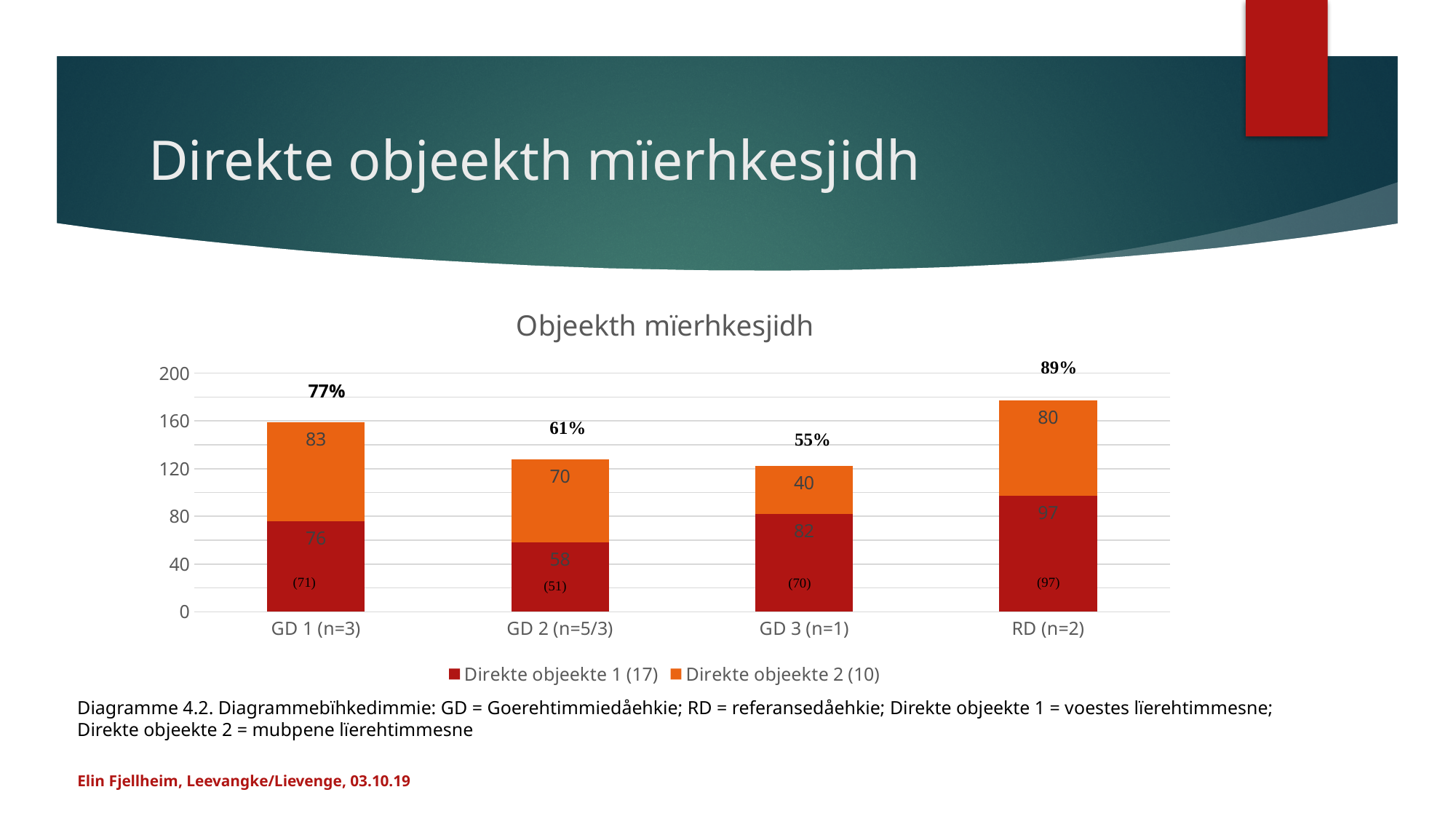
Which is larger: Direkte objeekte 1 (17) for GD 3 (n=1) or Direkte objeekte 1 (17) for GD 1 (n=3)? GD 3 (n=1) Which category has the highest value for Direkte objeekte 2 (10)? GD 1 (n=3) How many categories are shown on the x axis? 4 What is the value of Direkte objeekte 2 (10) for GD 3 (n=1)? 40 What is the total of the stacked bar for RD (n=2)? 177 What is the difference between the Direkte objeekte 2 (10) values for GD 2 (n=5/3) and GD 3 (n=1)? 30 What is the value of Direkte objeekte 1 (17) for GD 1 (n=3)? 76 How many series does the legend list? 2 What percentage is printed above the bar for GD 2 (n=5/3)? 61% Which category has the lowest value for Direkte objeekte 1 (17)? GD 2 (n=5/3) What is the value of Direkte objeekte 1 (17) for RD (n=2)? 97 What kind of chart is shown on the slide? stacked bar chart